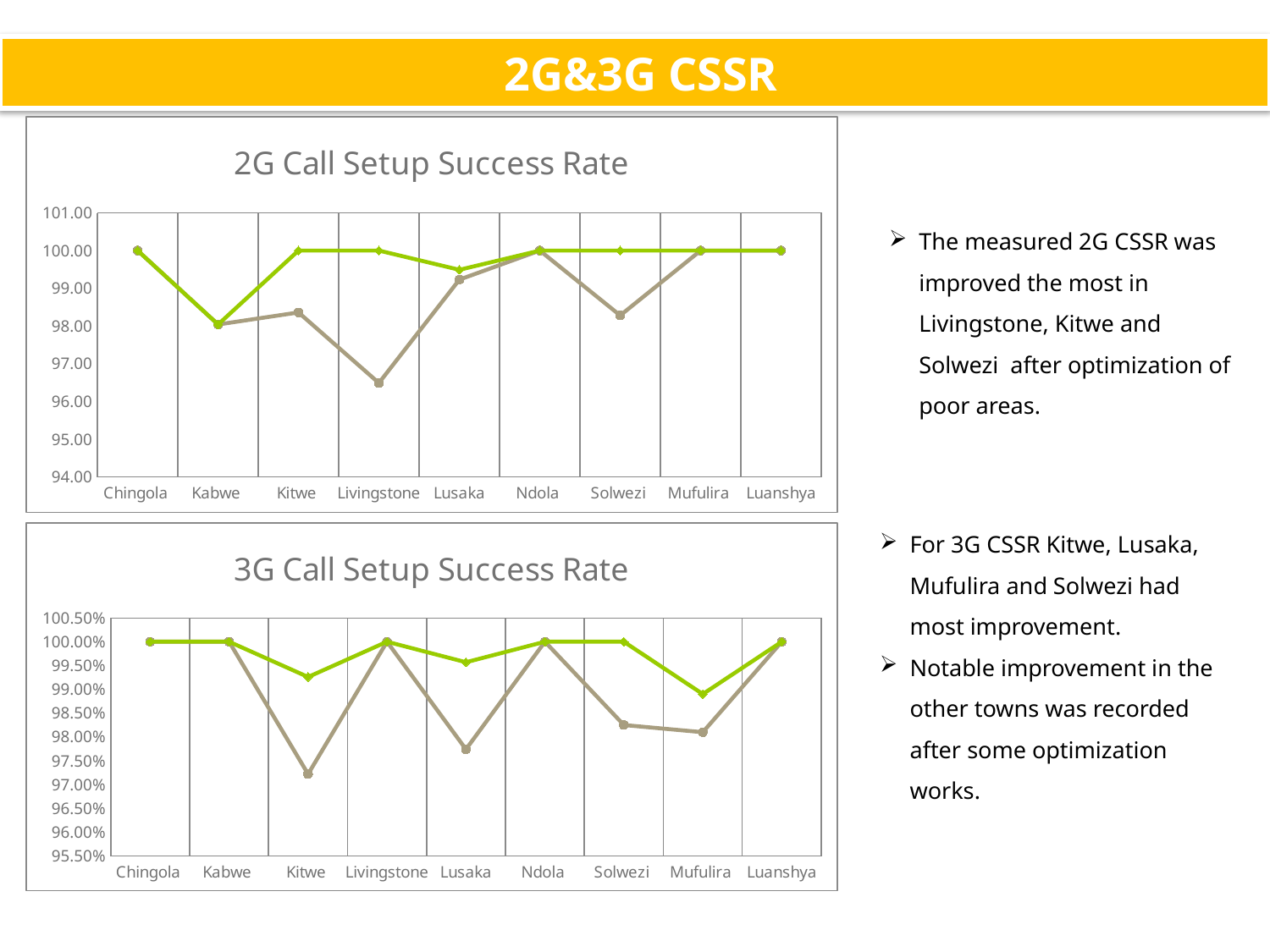
How many towns are shown on the x axis of the 3G Call Setup Success Rate chart? 9 In the 2G Call Setup Success Rate chart, what value does the grey line show for Chingola? 100.00 In the 3G Call Setup Success Rate chart, is the grey line's value for Kitwe greater or less than 97.50%? less In the 2G Call Setup Success Rate chart, is the grey line's value for Livingstone greater or less than 97.00? less In the 3G Call Setup Success Rate chart, which town has the lowest value on the grey line? Kitwe In the 3G Call Setup Success Rate chart, what value does the grey line show for Ndola? 100.00% In the 2G Call Setup Success Rate chart, which town has the lowest value on the grey line? Livingstone What type of chart is the 2G Call Setup Success Rate chart? line chart In the 3G Call Setup Success Rate chart, is the grey line's value for Lusaka greater or less than 98.00%? less In the 2G Call Setup Success Rate chart, at Livingstone, which line is higher, the green line or the grey line? the green line What is the title of the top chart on the slide? 2G Call Setup Success Rate